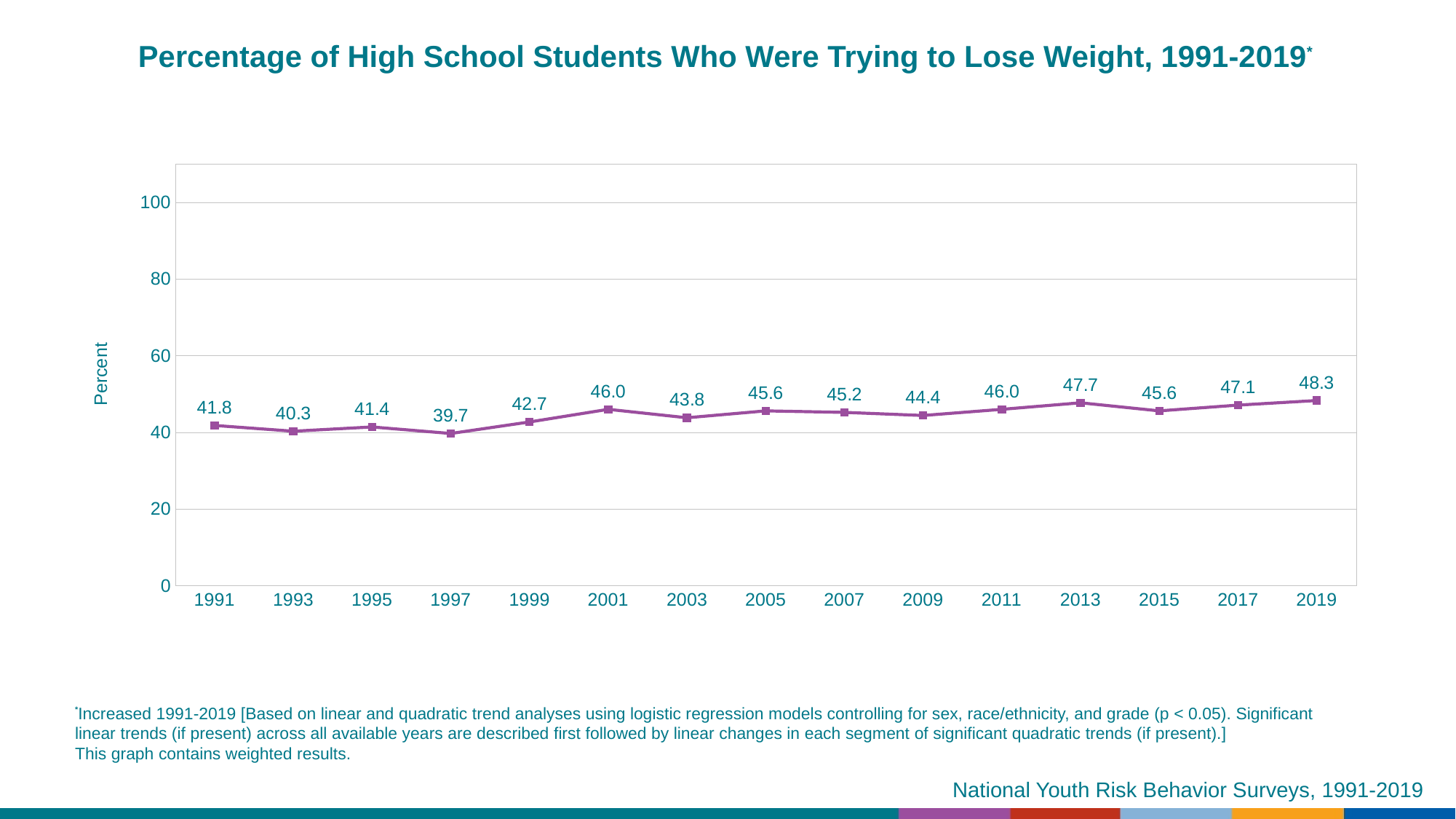
What is the label on the y axis? Percent Overall, do the values rise or fall from 1991 to 2019? rise How many years are plotted on the x axis? 15 Is the value for 2009 greater or less than 40? greater What kind of chart is shown on the slide? line chart Which year has the highest percentage of students trying to lose weight? 2019 Which year has a higher value, 2003 or 2005? 2005 What was the percentage of high school students trying to lose weight in 2019? 48.3 What value is shown for 2013? 47.7 What was the percentage of high school students trying to lose weight in 1991? 41.8 What is the difference between the 2019 value and the 1991 value? 6.5 Which year has the lowest percentage of students trying to lose weight? 1997